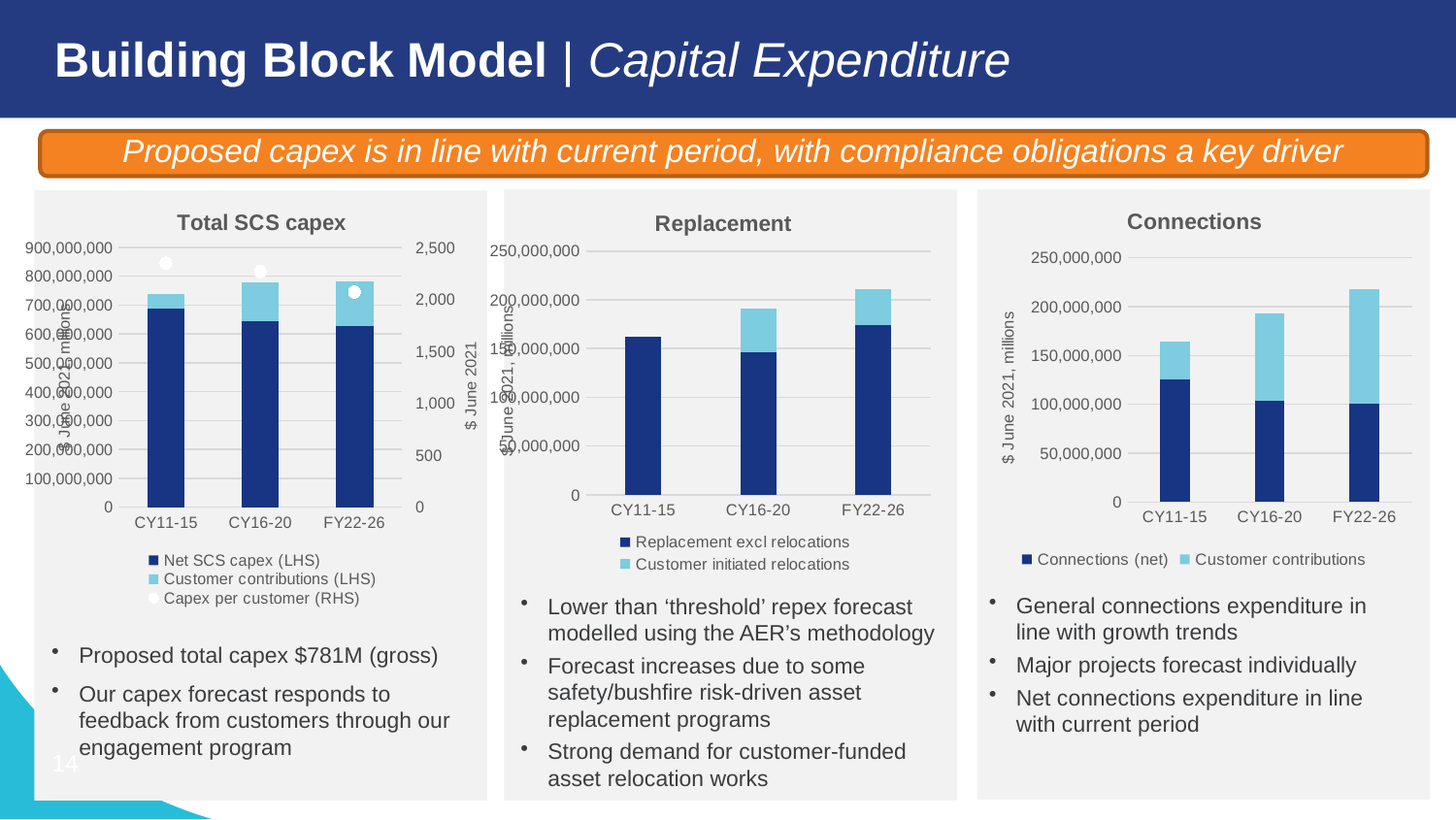
What kind of chart is the Replacement chart? Bar chart In the Connections chart, which period has the tallest total stacked bar? FY22-26 In the Total SCS capex chart, is the Capex per customer (RHS) value for CY11-15 greater or less than 2,000? greater In the Replacement chart, is the total stacked bar for FY22-26 greater or less than 200,000,000? greater How many series does the legend of the Total SCS capex chart list? 3 How many series does the legend of the Connections chart list? 2 How many periods are shown on the x axis of the Connections chart? 3 In the Connections chart, do the total stacked bars rise or fall from CY11-15 to FY22-26? rise In the Total SCS capex chart, which series is plotted against the right-hand (RHS) axis? Capex per customer In the Total SCS capex chart, do the Capex per customer (RHS) points rise or fall from CY11-15 to FY22-26? fall In the Replacement chart, which period has the shortest total stacked bar? CY11-15 In the Connections chart, is the Connections (net) value for FY22-26 greater or less than 150,000,000? less